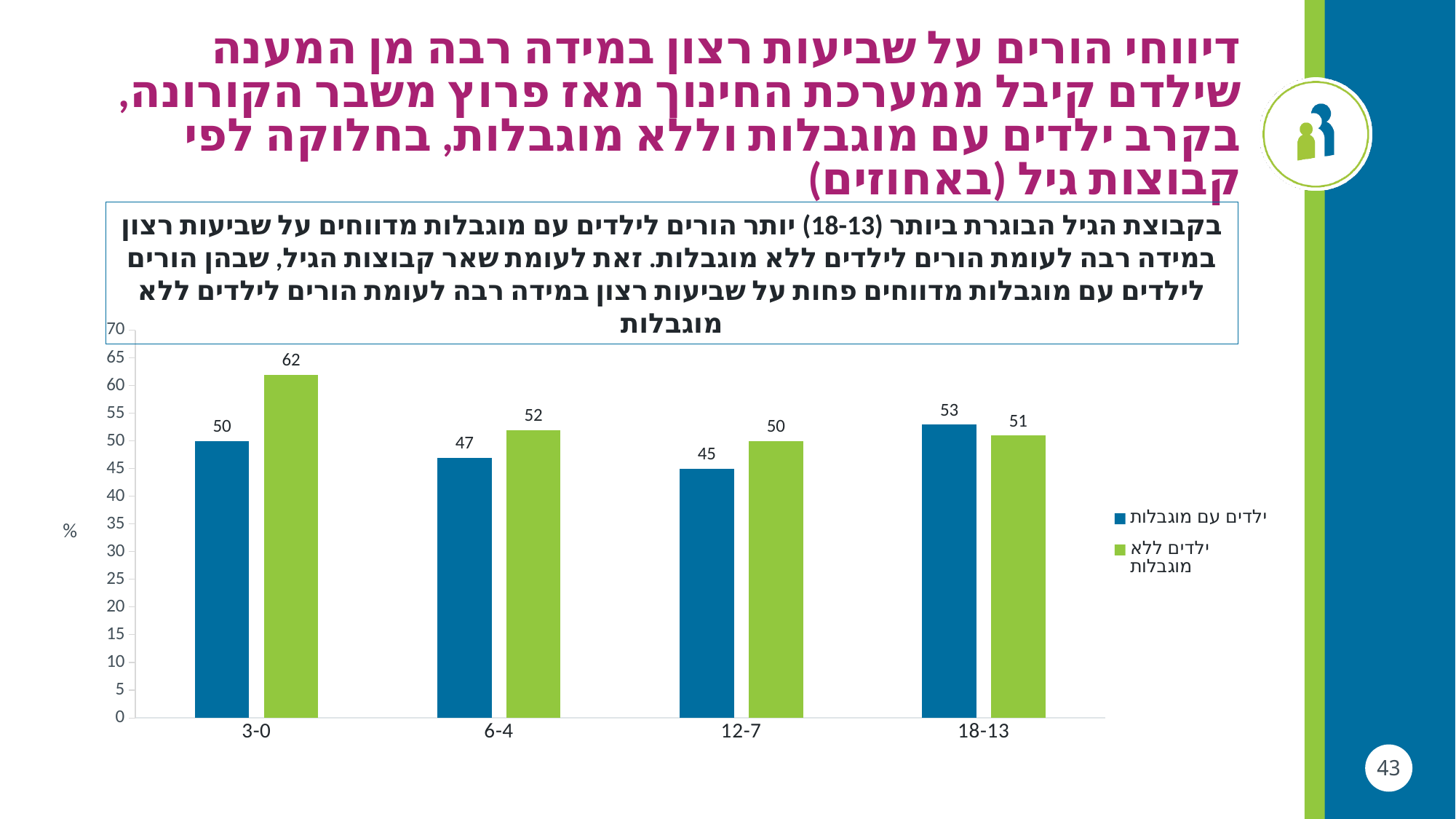
What is the value for ילדים עם מוגבלות (children with disabilities) in the 12-7 age group? 45 What is the value for ילדים ללא מוגבלות (children without disabilities) in the 3-0 age group? 62 Which colour represents ילדים ללא מוגבלות (children without disabilities) in the chart? green What is the difference between the two series in the 3-0 age group? 12 Which age group has the lowest value for ילדים עם מוגבלות (children with disabilities)? 12-7 What is the value for ילדים עם מוגבלות (children with disabilities) in the 18-13 age group? 53 Which age group has the highest value for ילדים ללא מוגבלות (children without disabilities)? 3-0 How many age groups are shown on the x axis? 4 Is the value for ילדים ללא מוגבלות (children without disabilities) in the 6-4 age group greater or less than 50? greater What kind of chart is shown on the slide? bar chart In the 18-13 age group, which series has the larger value? ילדים עם מוגבלות (children with disabilities) How many series does the legend list? 2